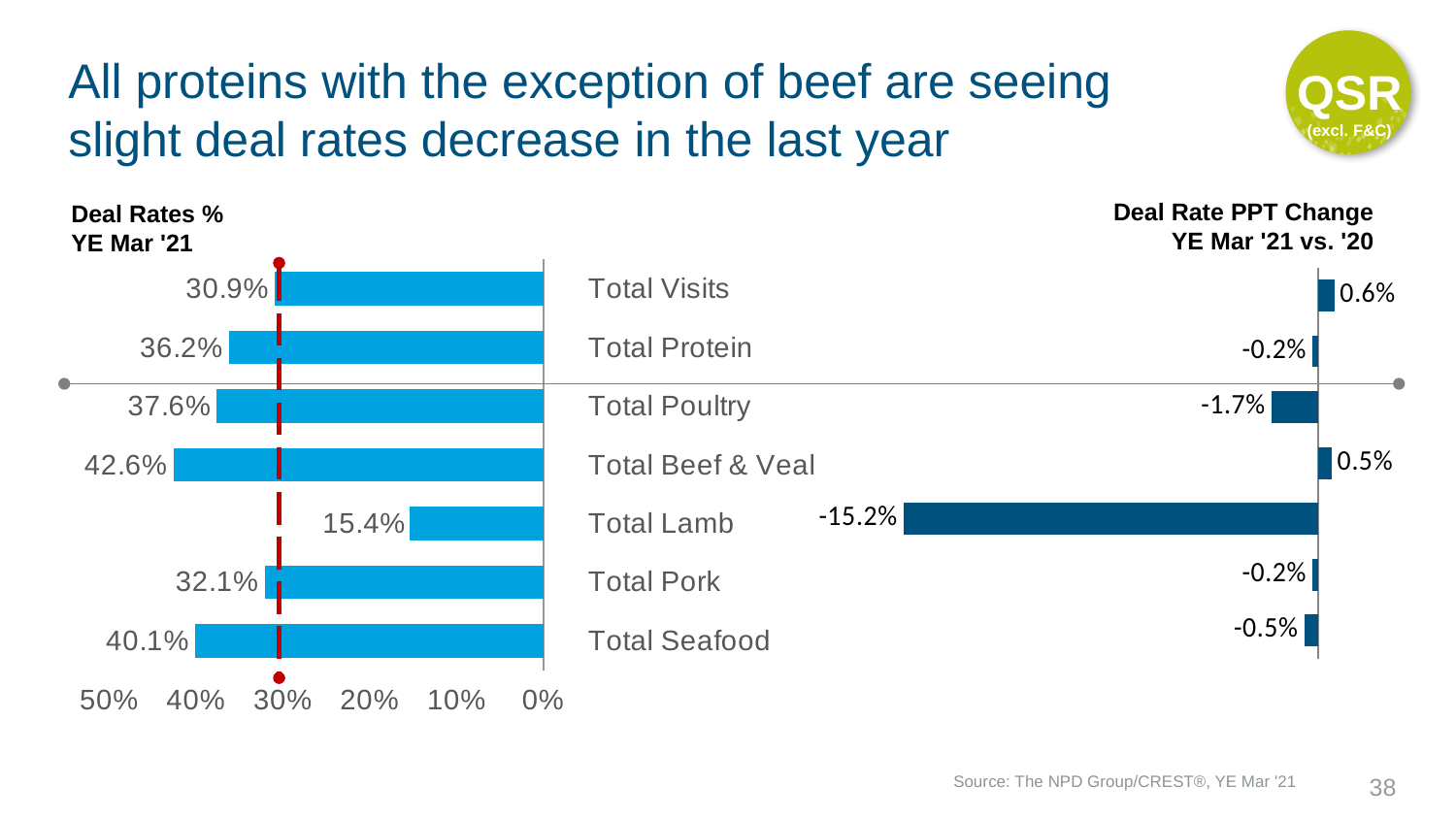
How many categories are shown in the Deal Rates % YE Mar '21 chart? 7 In the Deal Rate PPT Change YE Mar '21 vs. '20 chart, what is the value for Total Lamb? -15.2% In the Deal Rates % YE Mar '21 chart, which category has the lowest deal rate? Total Lamb In the Deal Rates % YE Mar '21 chart, what is the value for Total Lamb? 15.4% In the Deal Rate PPT Change YE Mar '21 vs. '20 chart, what is the value for Total Poultry? -1.7% In the Deal Rates % YE Mar '21 chart, what is the difference between Total Seafood and Total Pork? 8.0% In the Deal Rates % YE Mar '21 chart, which is larger, Total Poultry or Total Protein? Total Poultry In the Deal Rate PPT Change YE Mar '21 vs. '20 chart, which category has the lowest value? Total Lamb In the Deal Rates % YE Mar '21 chart, what is the value for Total Beef & Veal? 42.6% In the Deal Rate PPT Change YE Mar '21 vs. '20 chart, which category has the largest positive change? Total Visits In the Deal Rates % YE Mar '21 chart, which category has the highest deal rate? Total Beef & Veal What kind of chart is the Deal Rates % YE Mar '21 chart? Bar chart